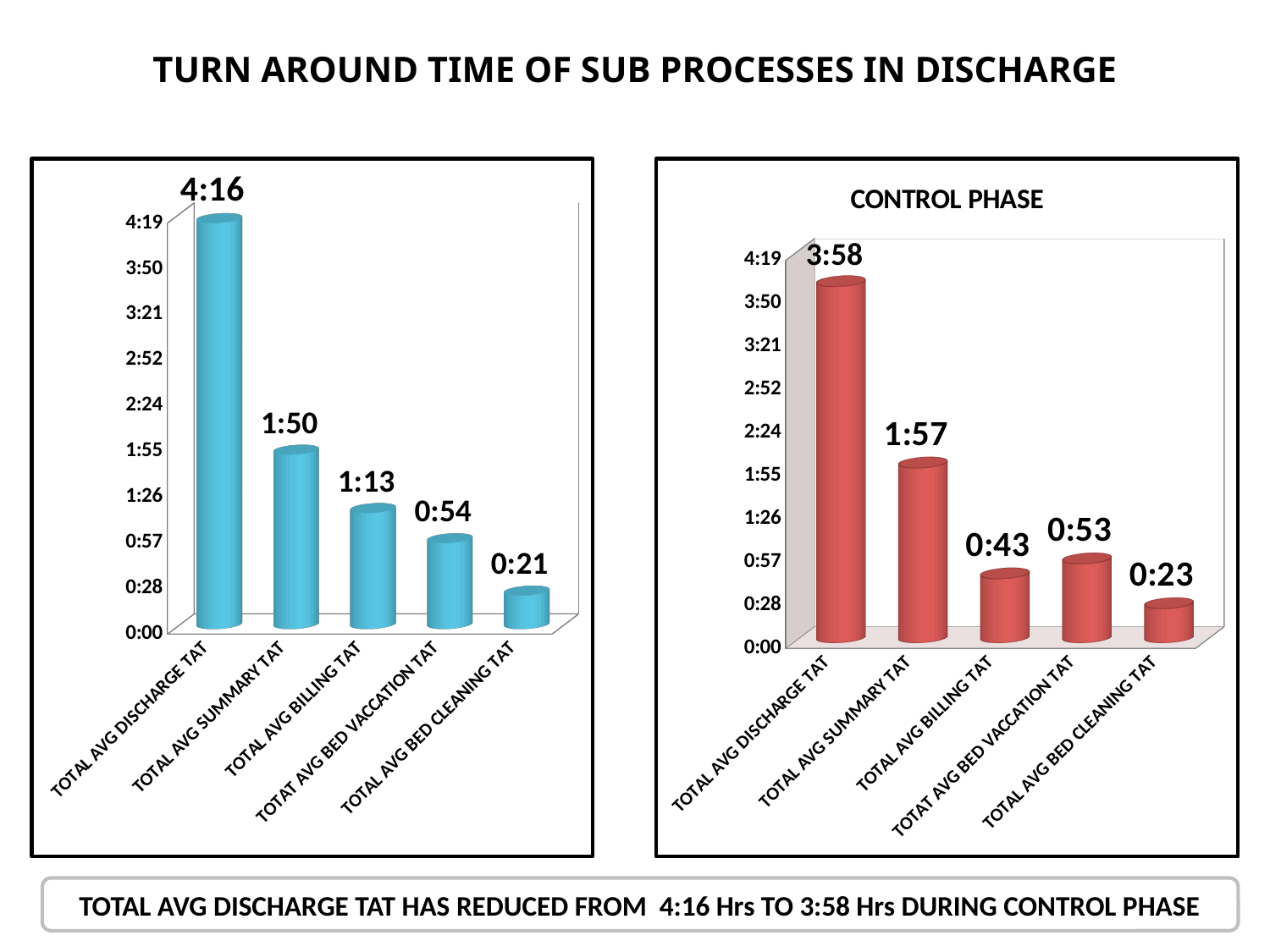
In the CONTROL PHASE chart, what is the value for TOTAL AVG BED CLEANING TAT? 0:23 In the CONTROL PHASE chart, which category has the lowest value? TOTAL AVG BED CLEANING TAT What colour are the bars in the CONTROL PHASE chart? Red In the CONTROL PHASE chart, what is the value for TOTAL AVG DISCHARGE TAT? 3:58 How many categories are shown in the CONTROL PHASE chart? 5 What kind of chart is the left chart? Bar chart In the left chart, what is the value for TOTAL AVG DISCHARGE TAT? 4:16 In the left chart, what is the value for TOTAL AVG BILLING TAT? 1:13 What is the difference between TOTAL AVG DISCHARGE TAT in the left chart (4:16) and in the CONTROL PHASE chart (3:58)? 0:18 In the left chart, which category has the highest value? TOTAL AVG DISCHARGE TAT In the left chart, do the values rise or fall from left to right along the x axis? Fall In the CONTROL PHASE chart, which is larger: TOTAL AVG BILLING TAT or TOTAT AVG BED VACCATION TAT? TOTAT AVG BED VACCATION TAT